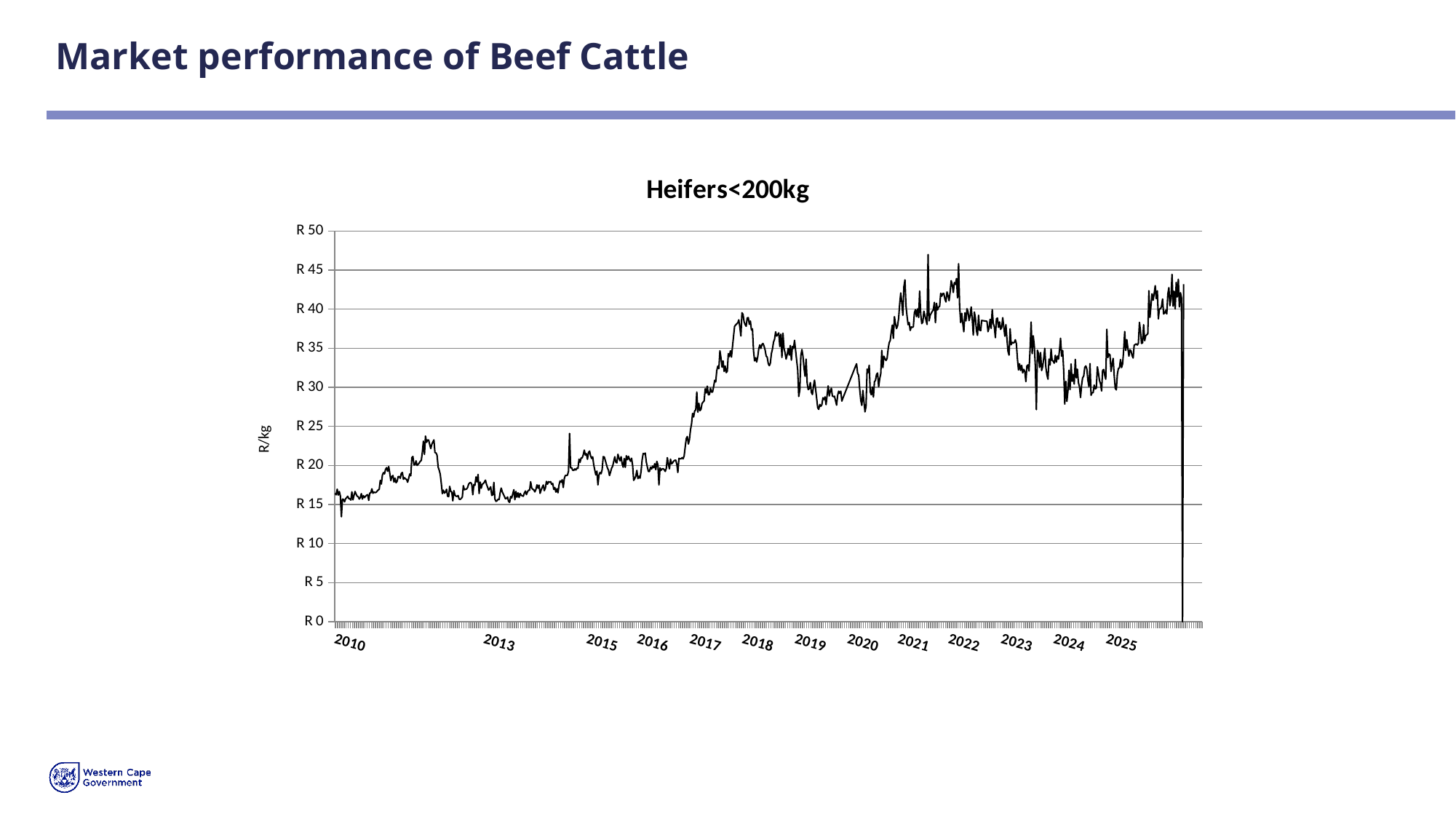
What is the label on the vertical axis of the chart? R/kg Is the value in 2021 greater or less than R 35? greater Is the value in 2013 greater or less than R 20? less Is the value in 2018 greater or less than R 30? greater Overall, does the price rise or fall from 2010 to 2025? rise What is the highest value shown on the vertical axis? R 50 What kind of chart is shown on the slide? line chart What is the title of the chart? Heifers<200kg